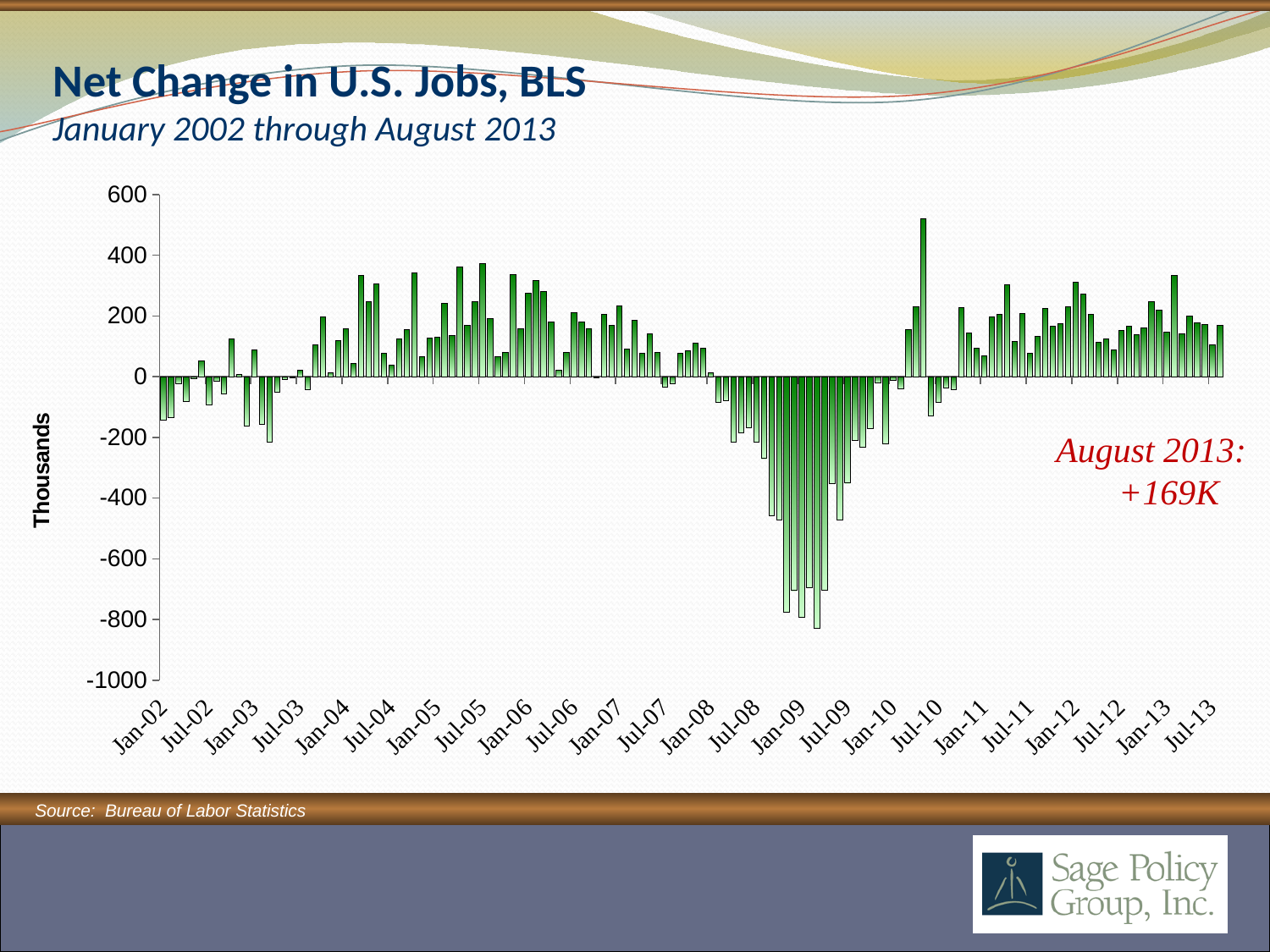
In which year does the tallest bar on the chart occur? 2010 Is the lowest (most negative) bar on the chart greater or less than -600? less Between Jan-08 and Jan-09, do the values rise or fall? fall What is the lowest value shown on the vertical axis? -1000 Is the tallest bar on the chart greater or less than 400? greater What is the title of the chart? Net Change in U.S. Jobs, BLS How many date labels are shown along the x axis? 24 What kind of chart is shown on the slide? bar chart What is the label on the vertical axis? Thousands In which year do the most negative bars on the chart occur? 2009 What is the net change in U.S. jobs for August 2013, as annotated on the chart? +169K